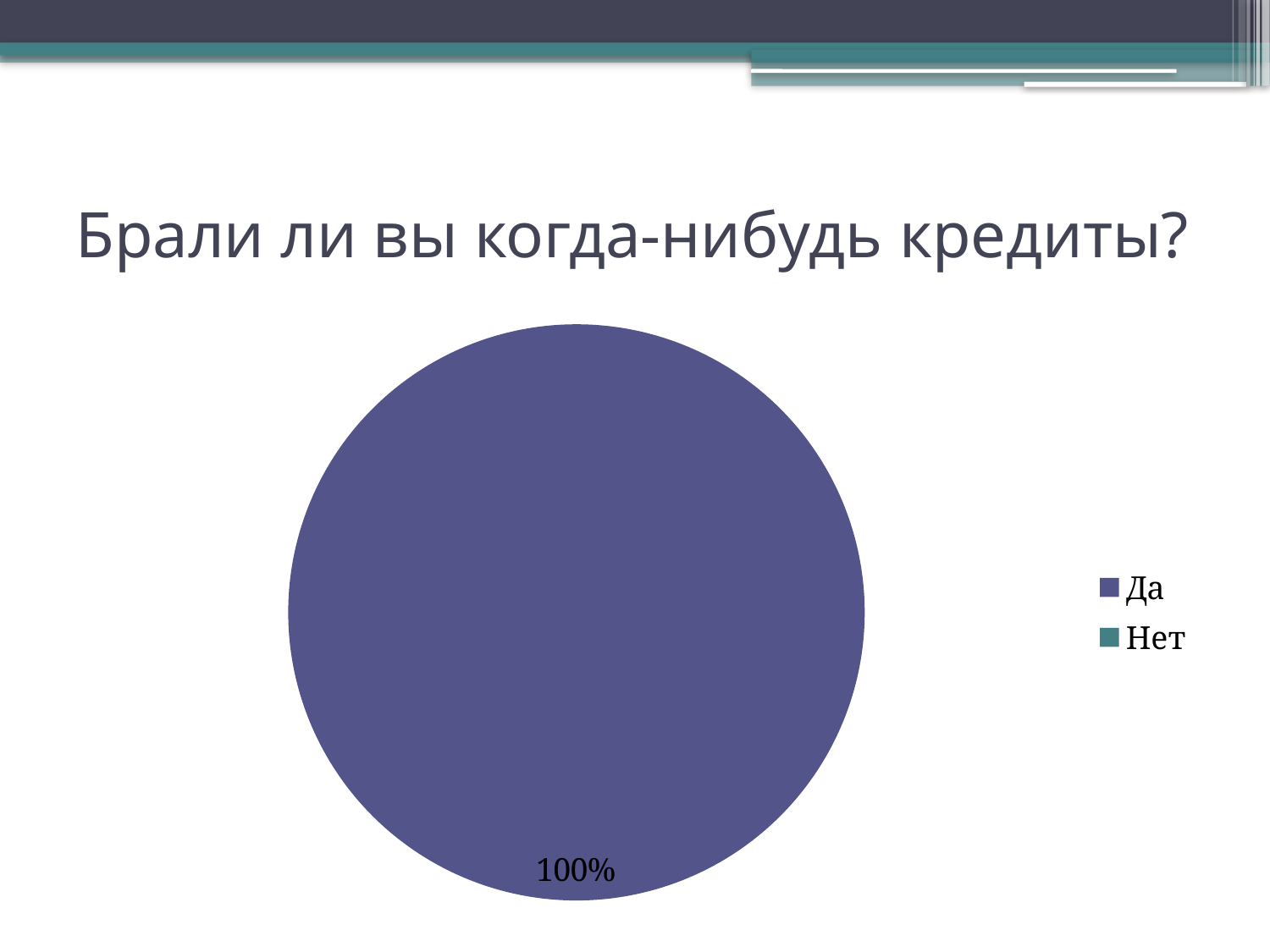
What kind of chart is shown on the slide? pie chart What value is printed on the pie chart? 100% What is the title of the slide above the chart? Брали ли вы когда-нибудь кредиты? Which is larger, the share for "Да" or the share for "Нет"? Да Is the share for "Да" greater or less than 50%? greater What share of the pie does the "Да" slice take? 100% Which legend entry is shown in the blue-purple colour? Да How many slices are visible in the pie chart? 1 How many entries does the legend list? 2 Which category has the largest share of the pie? Да